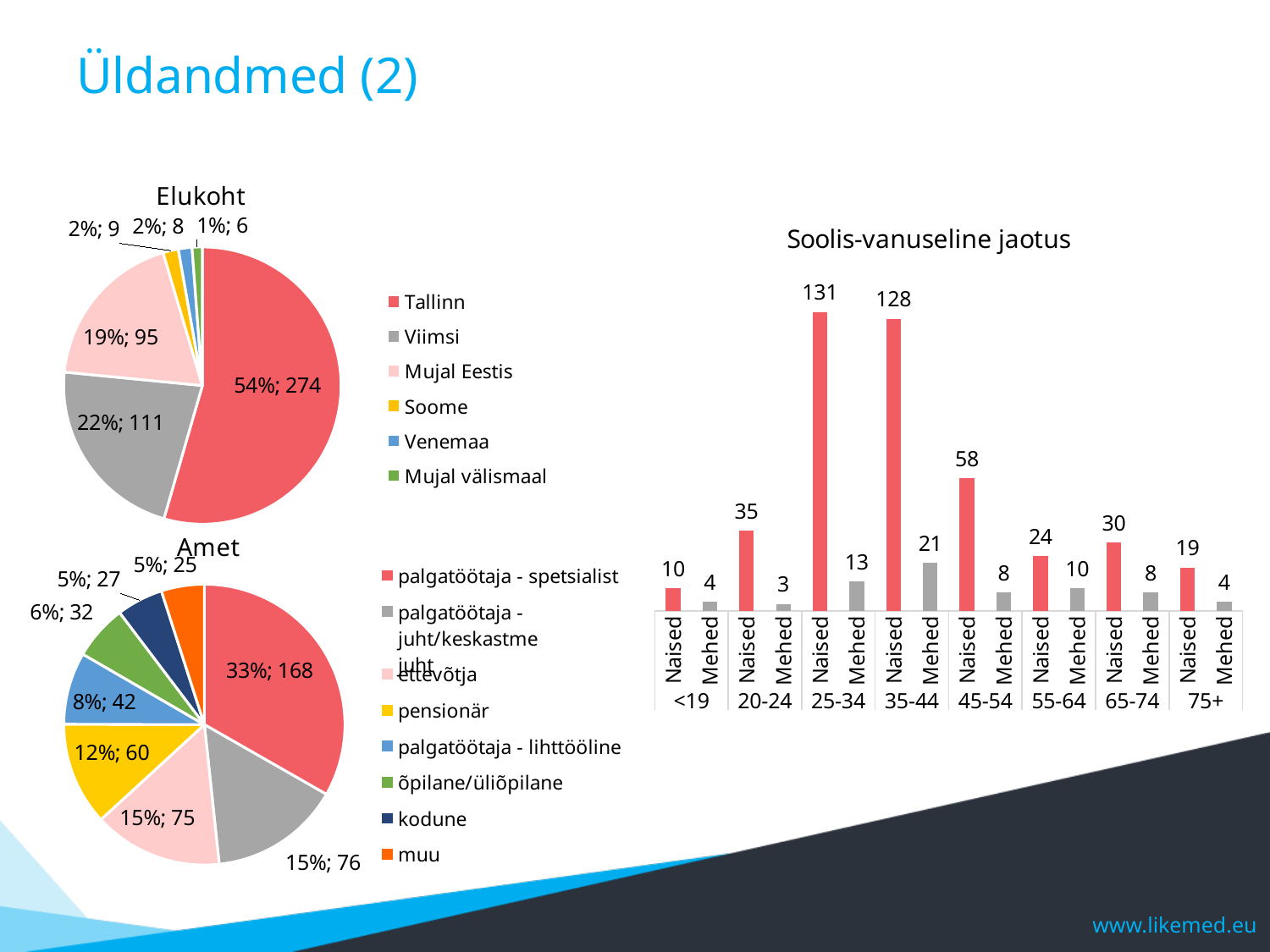
In the Amet pie chart, which category has the largest slice? palgatöötaja - spetsialist In the Elukoht pie chart, what value is shown for Tallinn? 54%; 274 In the Amet pie chart, what value is shown for pensionär? 12%; 60 In the Soolis-vanuseline jaotus chart, how many age groups are shown on the x axis? 8 What type of chart is Soolis-vanuseline jaotus? bar chart In the Elukoht pie chart, which category has the smallest slice? Mujal välismaal In the Amet pie chart, what is the difference in count between palgatöötaja - spetsialist (168) and ettevõtja (75)? 93 In the Elukoht pie chart, what share of the pie does Viimsi have? 22% In the Soolis-vanuseline jaotus chart, which is larger: Naised in 45-54 or Naised in 65-74? Naised in 45-54 In the Soolis-vanuseline jaotus chart, what is the value for Mehed in the 35-44 age group? 21 In the Soolis-vanuseline jaotus chart, what is the value for Naised in the 25-34 age group? 131 In the Elukoht pie chart, how many categories does the legend list? 6